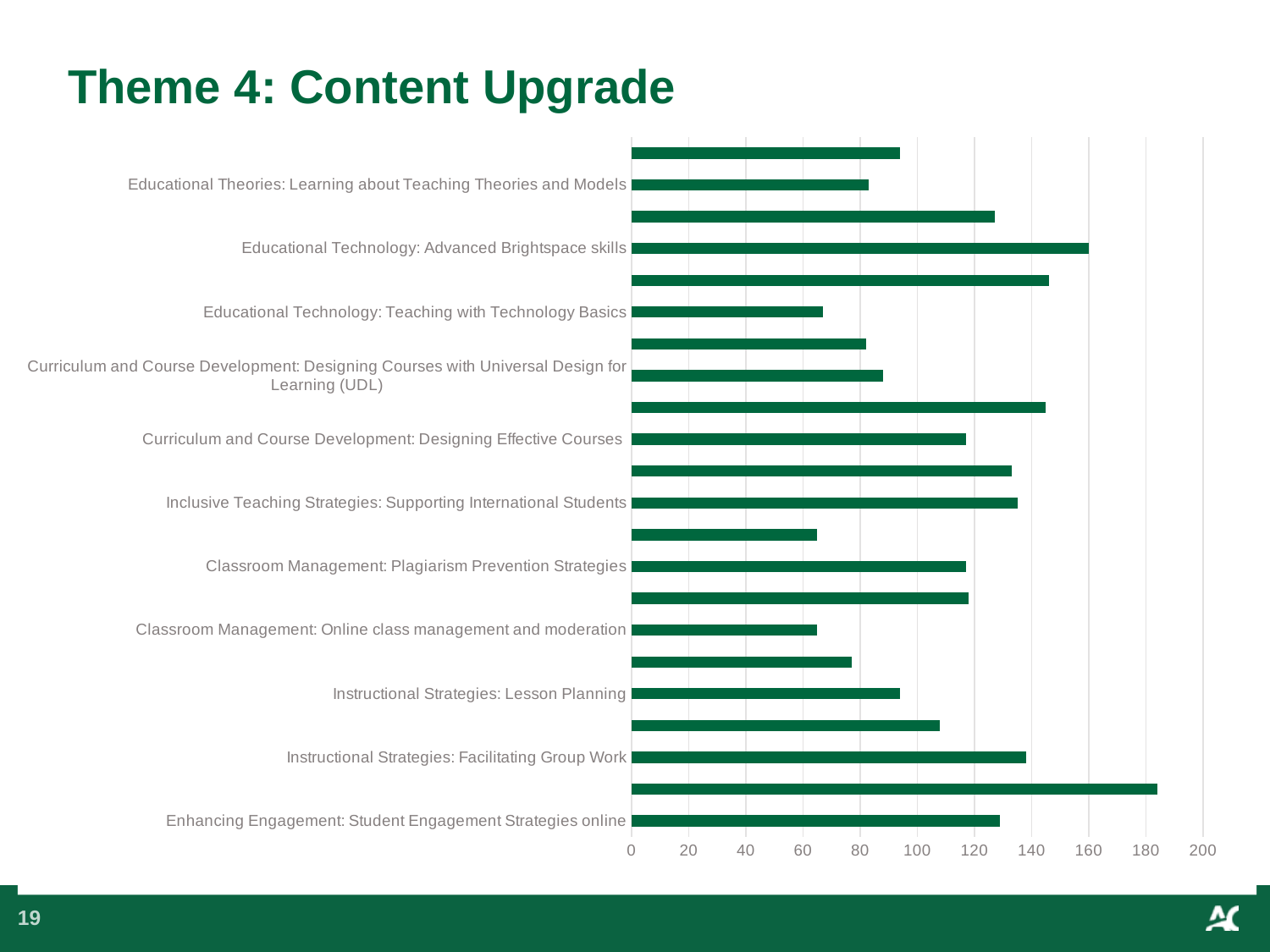
Is the value for Curriculum and Course Development: Designing Courses with Universal Design for Learning (UDL) greater or less than 100? less Which has a larger value: Inclusive Teaching Strategies: Supporting International Students or Instructional Strategies: Lesson Planning? Inclusive Teaching Strategies: Supporting International Students What kind of chart is shown on the slide? bar chart Which has a larger value: Educational Technology: Advanced Brightspace skills or Educational Technology: Teaching with Technology Basics? Educational Technology: Advanced Brightspace skills How many categories are labeled on the vertical axis of the chart? 11 What is the maximum value shown on the horizontal axis of the chart? 200 Is the value for Classroom Management: Online class management and moderation greater or less than 80? less Is the value for Educational Technology: Advanced Brightspace skills greater or less than 140? greater